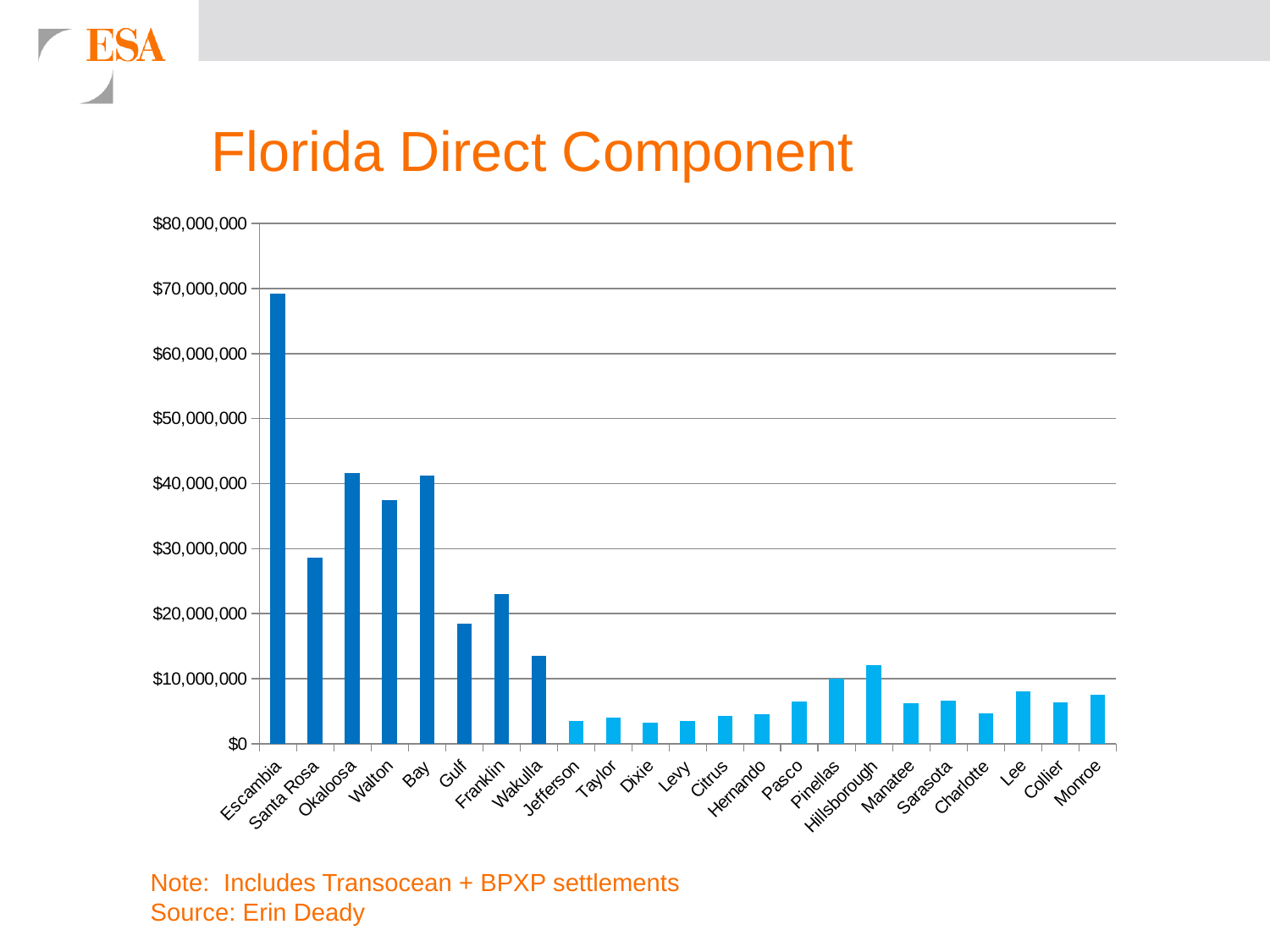
Which has the larger value, Franklin or Gulf? Franklin How many counties are shown on the x axis of the chart? 23 Is the value for Walton greater or less than $40,000,000? less Is the value for Hillsborough greater or less than $10,000,000? greater Is the value for Escambia greater or less than $60,000,000? greater Which has the larger value, Hillsborough or Manatee? Hillsborough What type of chart is shown on the slide? Bar chart What is the title of the chart? Florida Direct Component Which has the larger value, Okaloosa or Walton? Okaloosa Which county has the highest value in the chart? Escambia